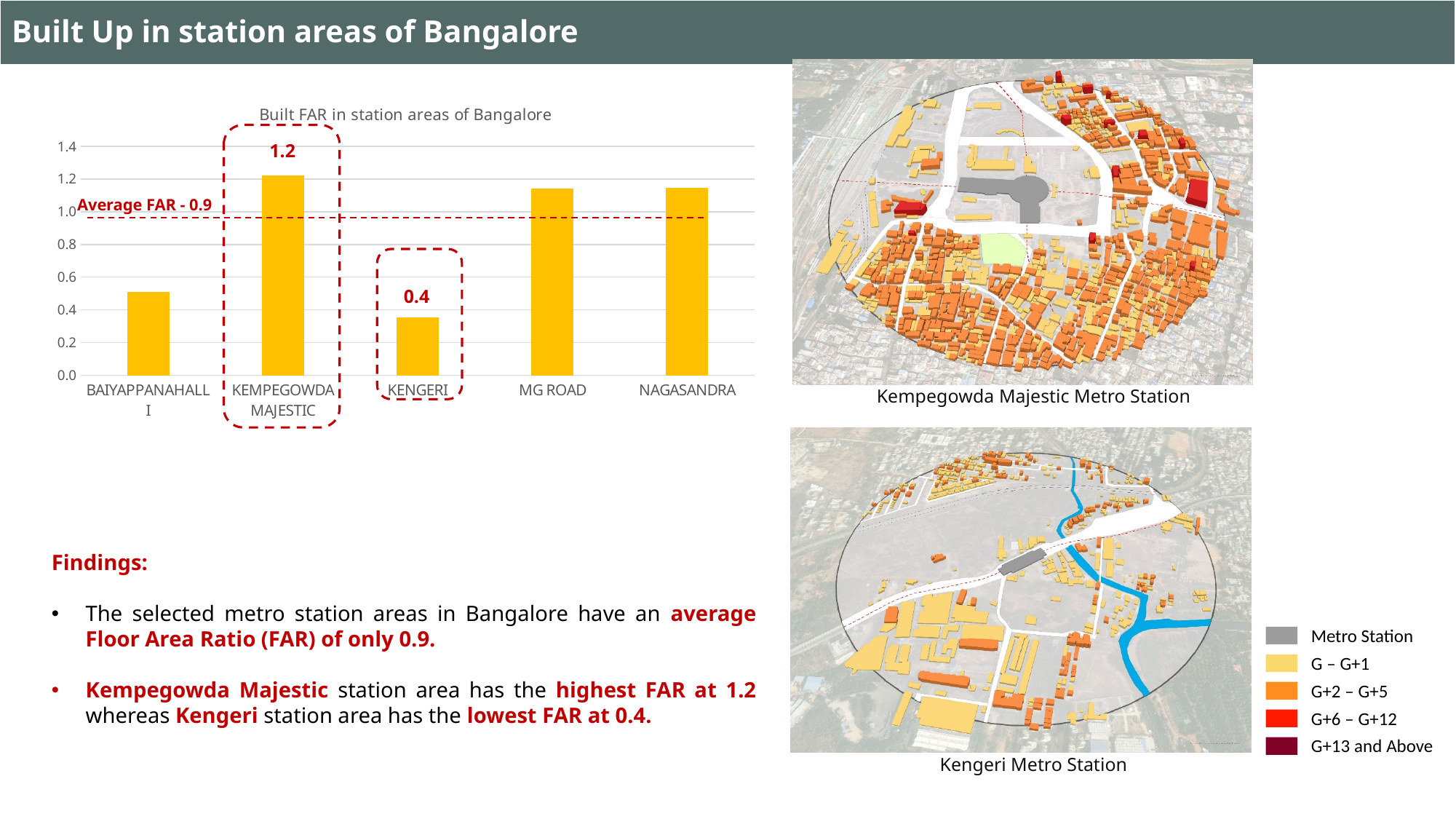
Which station area has the lowest Built FAR in the chart? Kengeri How many station areas are shown in the Built FAR chart? 5 What is the Built FAR value shown for Kempegowda Majestic? 1.2 What is the Built FAR value shown for Kengeri? 0.4 Which has a higher Built FAR, Baiyappanahalli or MG Road? MG Road Is the Built FAR value for Nagasandra greater or less than 1.0? greater What type of chart is used to show Built FAR in station areas of Bangalore? Bar chart Which station area has the highest Built FAR in the chart? Kempegowda Majestic What is the title of the chart on the slide? Built FAR in station areas of Bangalore What is the difference between the Built FAR of Kempegowda Majestic and Kengeri? 0.8 What average FAR value is marked by the dashed line on the chart? 0.9 Is the Built FAR value for Baiyappanahalli greater or less than 0.6? less